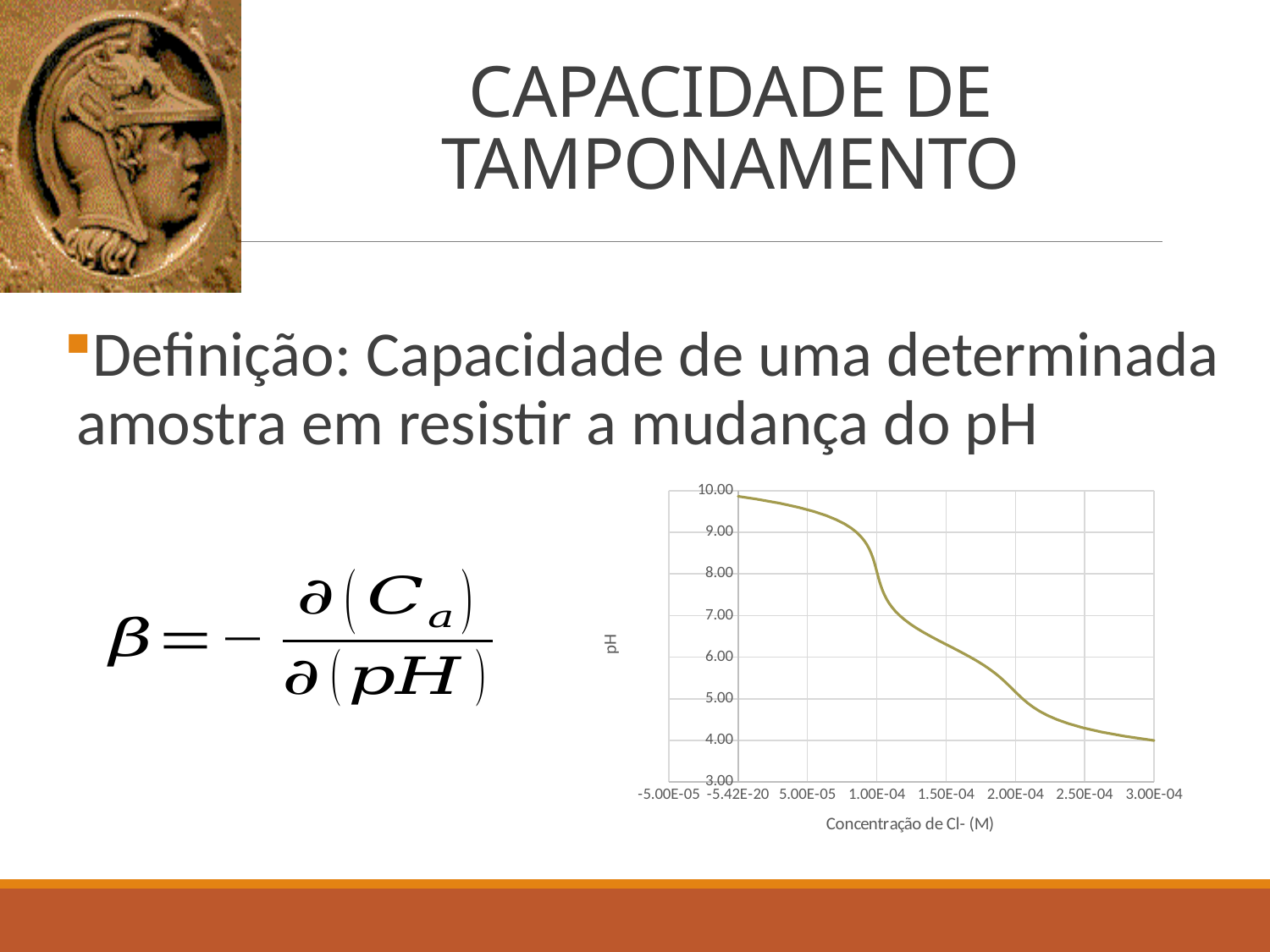
Is the pH at a Cl- concentration of 5.00E-05 greater or less than 9.00? greater What kind of chart is shown on the slide? line chart Is the pH at a Cl- concentration of 2.00E-04 greater or less than 6.00? less What is the highest value shown on the y axis of the chart? 10.00 What is the title of the y axis of the chart? pH Is the pH at a Cl- concentration of 3.00E-04 greater or less than 5.00? less What is the title of the x axis of the chart? Concentração de Cl- (M) Does the pH rise or fall as the concentration of Cl- increases along the x axis? fall